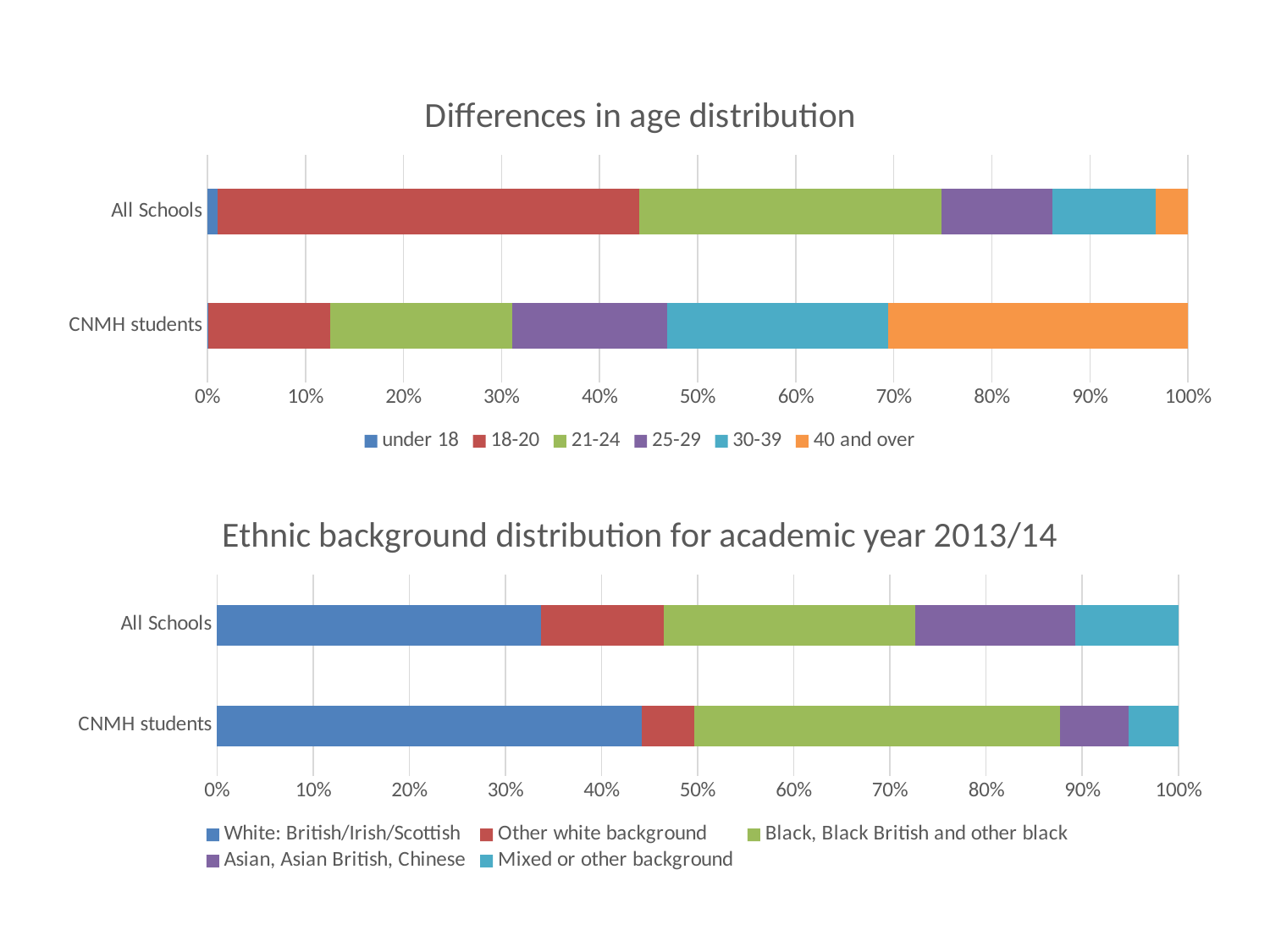
In the 'Ethnic background distribution for academic year 2013/14' chart, is the 'Other white background' share larger for All Schools or for CNMH students? All Schools What is the title of the lower chart on the slide? Ethnic background distribution for academic year 2013/14 In the 'Differences in age distribution' chart, is the '40 and over' share larger for All Schools or for CNMH students? CNMH students In the 'Differences in age distribution' chart, which age group is the largest segment for CNMH students? 40 and over In the 'Differences in age distribution' chart, which age group is the smallest segment for All Schools? under 18 In the 'Differences in age distribution' chart, is the '40 and over' segment for CNMH students greater or less than 20%? greater In the 'Ethnic background distribution for academic year 2013/14' chart, is the 'White: British/Irish/Scottish' segment for All Schools greater or less than 40%? less How many series does the legend of the 'Differences in age distribution' chart list? 6 In the 'Ethnic background distribution for academic year 2013/14' chart, which ethnic group is the largest segment for CNMH students? White: British/Irish/Scottish How many series does the legend of the 'Ethnic background distribution for academic year 2013/14' chart list? 5 How many categories (bars) are shown in the 'Differences in age distribution' chart? 2 What kind of chart is the 'Differences in age distribution' chart? Stacked bar chart